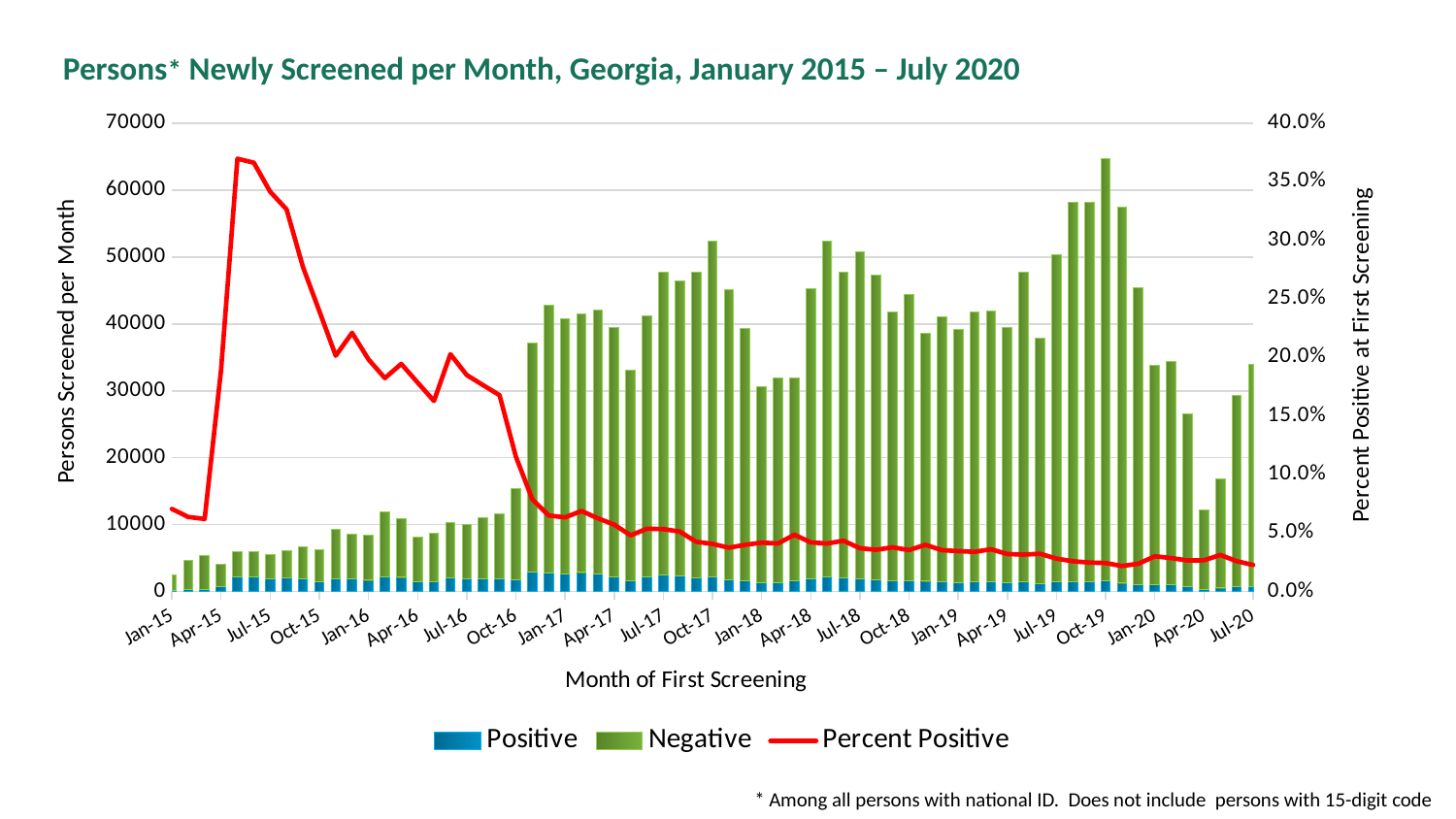
Is the Percent Positive value in Jul-20 greater or less than 5.0%? less What kind of chart is shown on the slide? A bar chart combined with a line chart Does the Percent Positive line rise or fall from Jul-15 to Jul-20? fall How many series does the legend list? 3 Is the total number of persons screened in Apr-20 greater or less than 20000? less Is the total number of persons screened in Oct-19 greater or less than 60000? greater What is the label of the x axis? Month of First Screening What are the three series listed in the legend? Positive, Negative, Percent Positive Which month has the tallest bar for persons screened? Oct-19